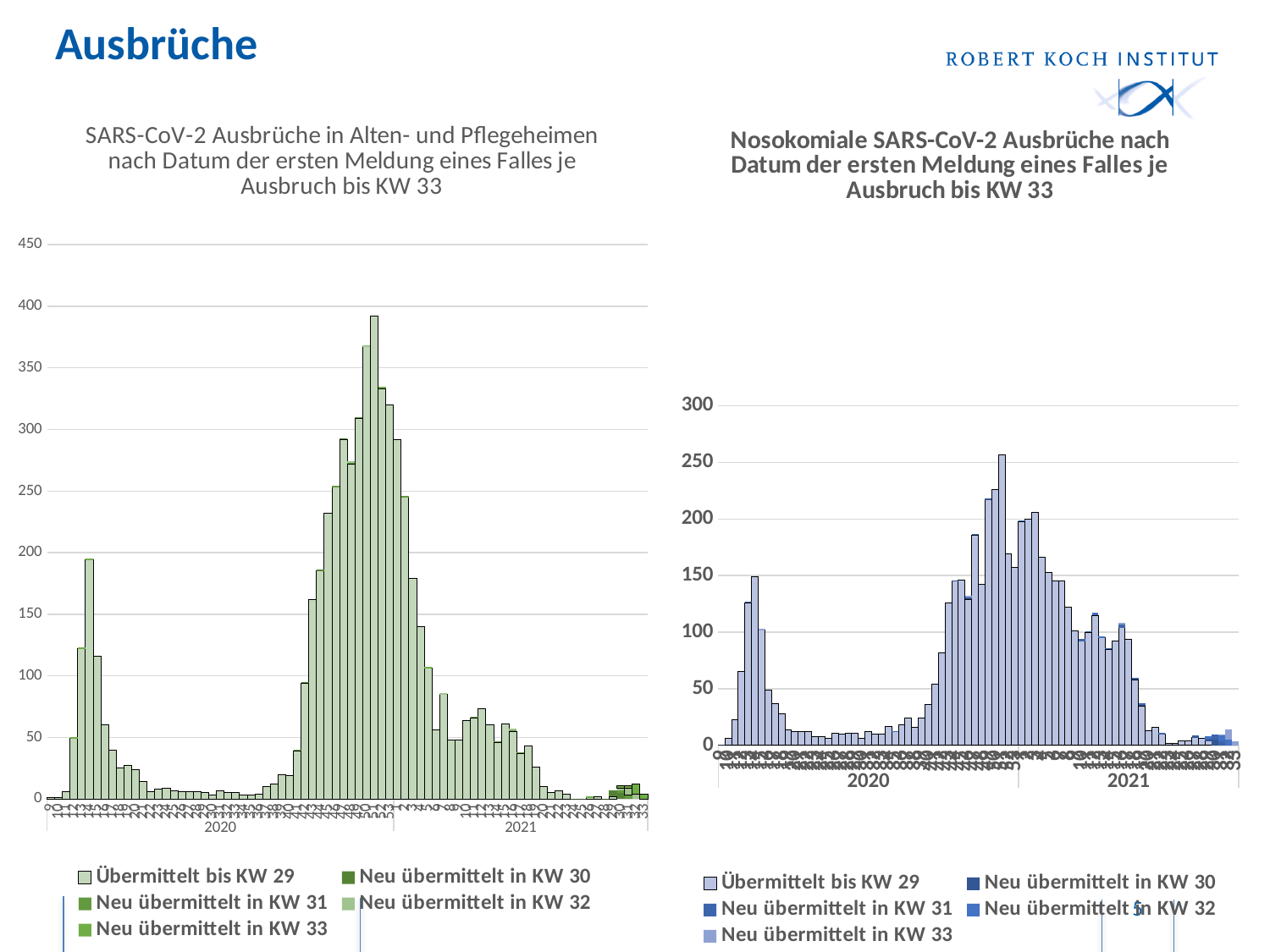
In the right chart, is the tallest bar greater or less than 200? greater How many series does the legend of the left chart list? 5 What kind of chart is the left chart, 'SARS-CoV-2 Ausbrüche in Alten- und Pflegeheimen'? bar chart What is the highest value shown on the y axis of the right chart? 300 In the left chart, does the tallest bar fall in the 2020 or the 2021 section of the x axis? 2020 In the left chart, is the tallest bar greater or less than 350? greater In the left chart, is the tallest bar greater or less than 400? less In the left chart, do the bars rise or fall from the tallest bar toward the right end of the x axis? fall What kind of chart is the right chart, 'Nosokomiale SARS-CoV-2 Ausbrüche'? bar chart What is the first legend entry of the left chart? Übermittelt bis KW 29 How many series does the legend of the right chart list? 5